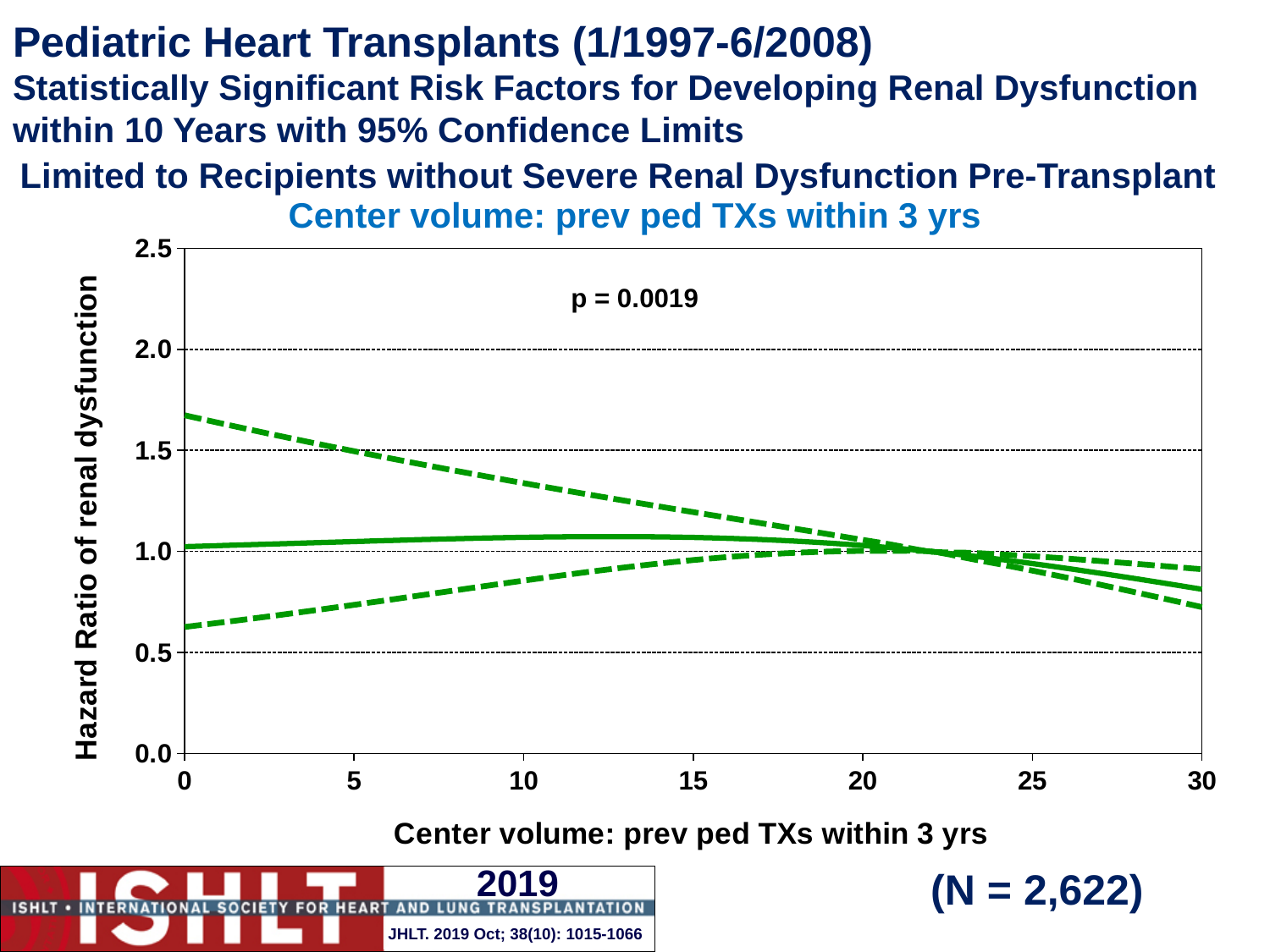
What is the N shown on the slide? N = 2,622 Is the lower dashed confidence limit at a center volume of 0 greater or less than 1.0? less Does the solid hazard ratio line rise or fall as center volume increases from 20 to 30? fall Is the lower dashed confidence limit at a center volume of 30 greater or less than 1.0? less How many lines are plotted on the chart? 3 What p-value is shown on the chart? p = 0.0019 Is the upper dashed confidence limit at a center volume of 0 greater or less than 1.5? greater Does the lower dashed confidence limit rise or fall as center volume increases from 0 to 20? rise What kind of chart is shown on the slide? line chart Does the upper dashed confidence limit rise or fall as center volume increases from 0 to 30? fall